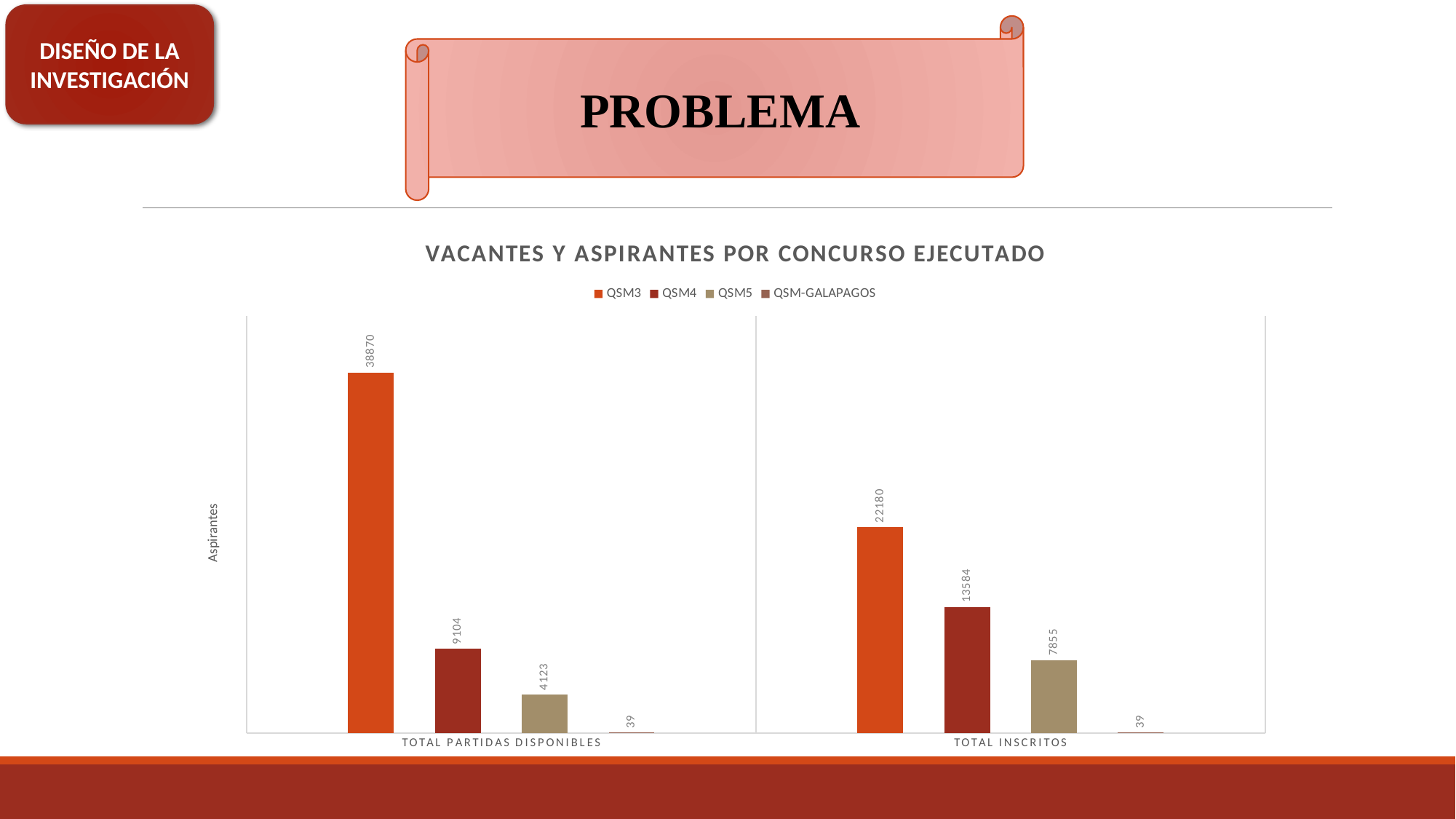
Which series has the lowest value in the TOTAL PARTIDAS DISPONIBLES category? QSM-GALAPAGOS What is the value for QSM-GALAPAGOS in the TOTAL INSCRITOS category? 39 What is the difference between QSM4 and QSM5 in the TOTAL INSCRITOS category? 5729 What is the difference between the QSM3 values for TOTAL PARTIDAS DISPONIBLES and TOTAL INSCRITOS? 16690 What is the value for QSM4 in the TOTAL INSCRITOS category? 13584 Which is larger: QSM4 in TOTAL PARTIDAS DISPONIBLES or QSM5 in TOTAL INSCRITOS? QSM4 in TOTAL PARTIDAS DISPONIBLES What is the value for QSM5 in the TOTAL PARTIDAS DISPONIBLES category? 4123 Which series has the highest value in the TOTAL INSCRITOS category? QSM3 What kind of chart is shown on the slide? Bar chart How many categories are shown on the x axis? 2 What is the value for QSM3 in the TOTAL PARTIDAS DISPONIBLES category? 38870 How many series does the legend list? 4